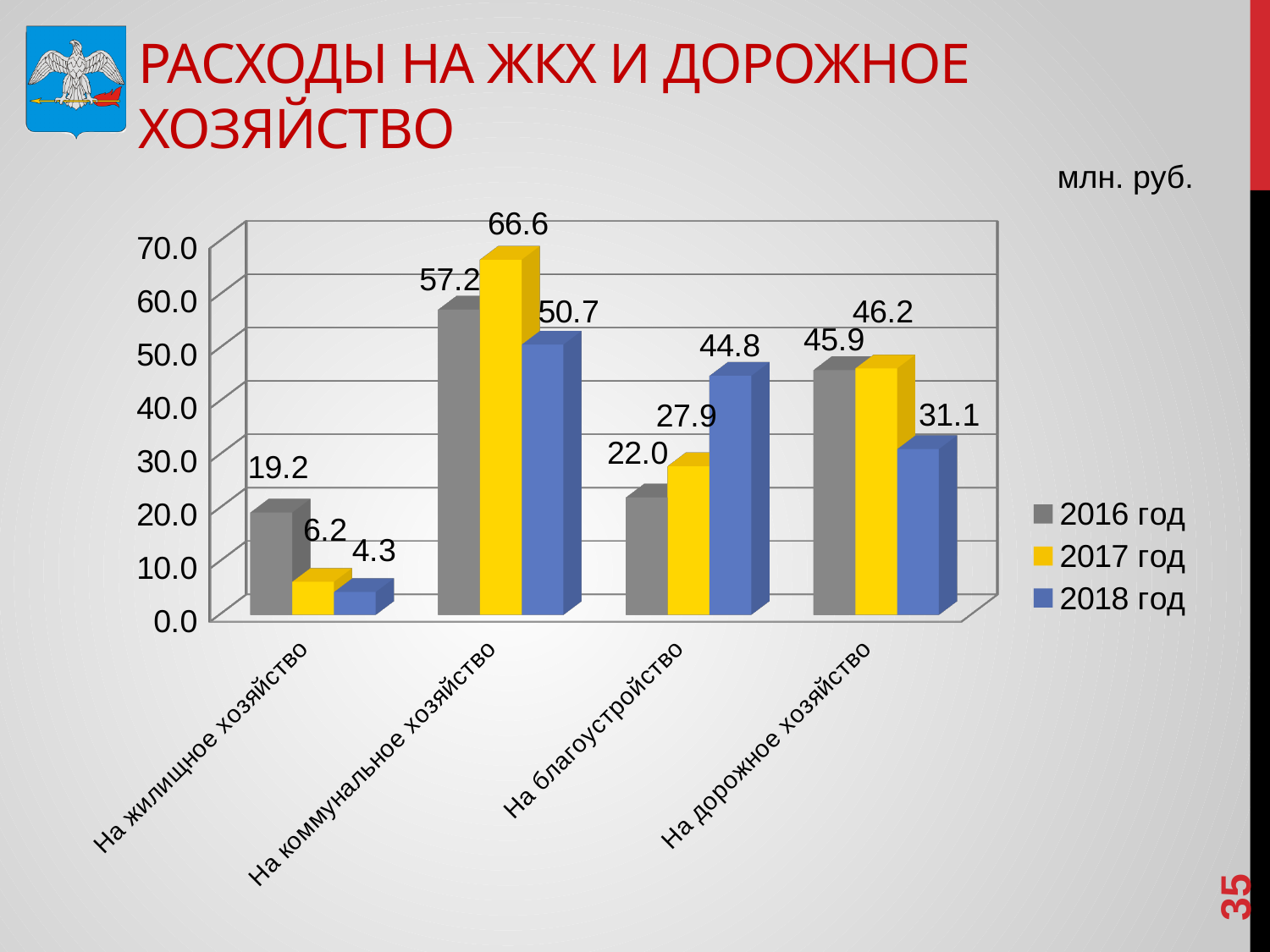
What is the difference between the 2017 год and 2016 год values for На коммунальное хозяйство? 9.4 Which category has the lowest value in 2017 год? На жилищное хозяйство What is the value for На благоустройство in 2018 год? 44.8 What unit is indicated above the chart? млн. руб. What is the value for На жилищное хозяйство in 2016 год? 19.2 Do the values for На благоустройство rise or fall from 2016 год to 2018 год? Rise How many series does the legend list? 3 What is the value for На коммунальное хозяйство in 2017 год? 66.6 How many categories are shown on the x axis? 4 What kind of chart is shown on the slide? Bar chart Which category has the highest value in 2018 год? На коммунальное хозяйство Which is larger for На дорожное хозяйство: the 2016 год value or the 2018 год value? 2016 год